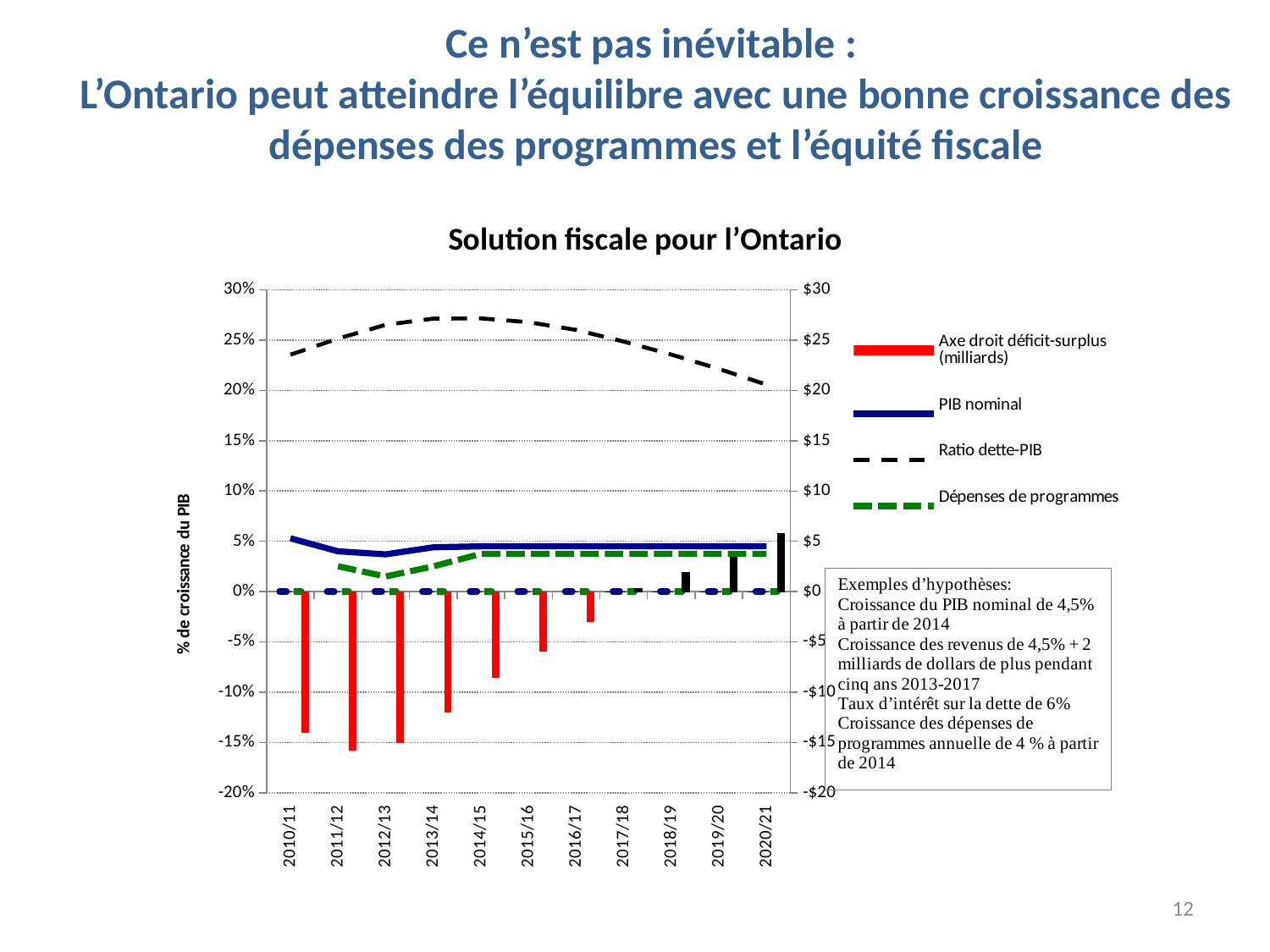
Is the Ratio dette-PIB value for 2020/21 greater or less than 25%? less What kind of chart is shown on the slide? A combined bar and line chart Which series in the chart is drawn as red bars? Axe droit déficit-surplus (milliards) Is the déficit-surplus value for 2010/11 greater or less than -$10? less Does the Ratio dette-PIB line rise or fall from 2014/15 to 2020/21? fall Is the Dépenses de programmes value for 2012/13 greater or less than 5%? less How many series does the chart legend list? 4 How many fiscal years are shown on the x axis of the chart? 11 In which fiscal year is the déficit-surplus bar the highest? 2020/21 What is the title of the chart on the slide? Solution fiscale pour l'Ontario Which is larger, the déficit-surplus value for 2010/11 or for 2016/17? 2016/17